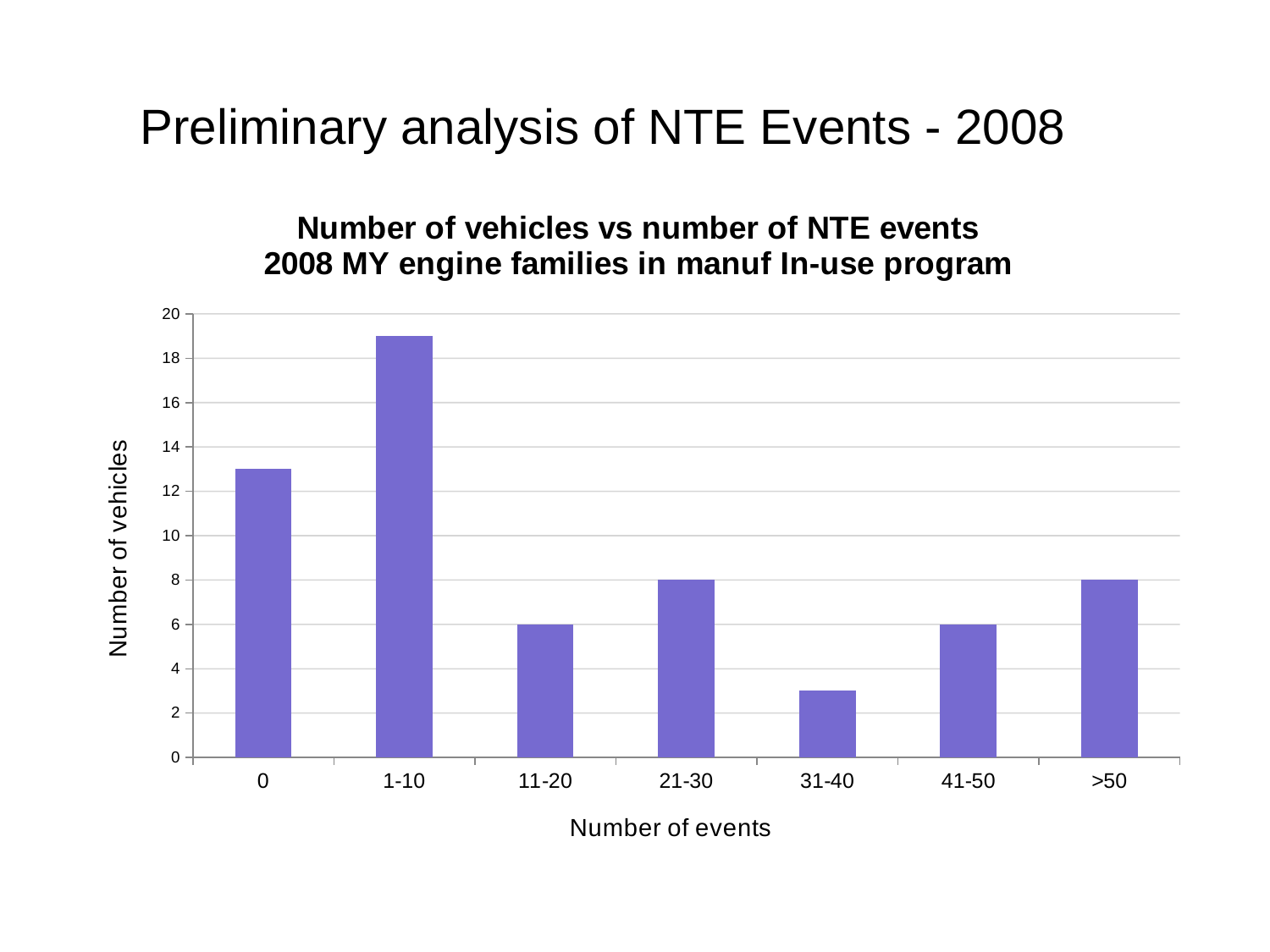
How many categories are shown on the x axis of the chart? 7 Is the number of vehicles for the 0 events category greater or less than 12? greater What is the number of vehicles for the >50 events category? 8 Which number-of-events category has the highest number of vehicles? 1-10 What kind of chart is shown on the slide? bar chart Which number-of-events category has the lowest number of vehicles? 31-40 What is the number of vehicles for the 11-20 events category? 6 What is the label of the y axis of the chart? Number of vehicles Which has more vehicles: the 0 events category or the 1-10 events category? 1-10 Is the number of vehicles for the 31-40 events category greater or less than 4? less What is the number of vehicles for the 21-30 events category? 8 What is the difference in number of vehicles between the 21-30 and 41-50 categories? 2